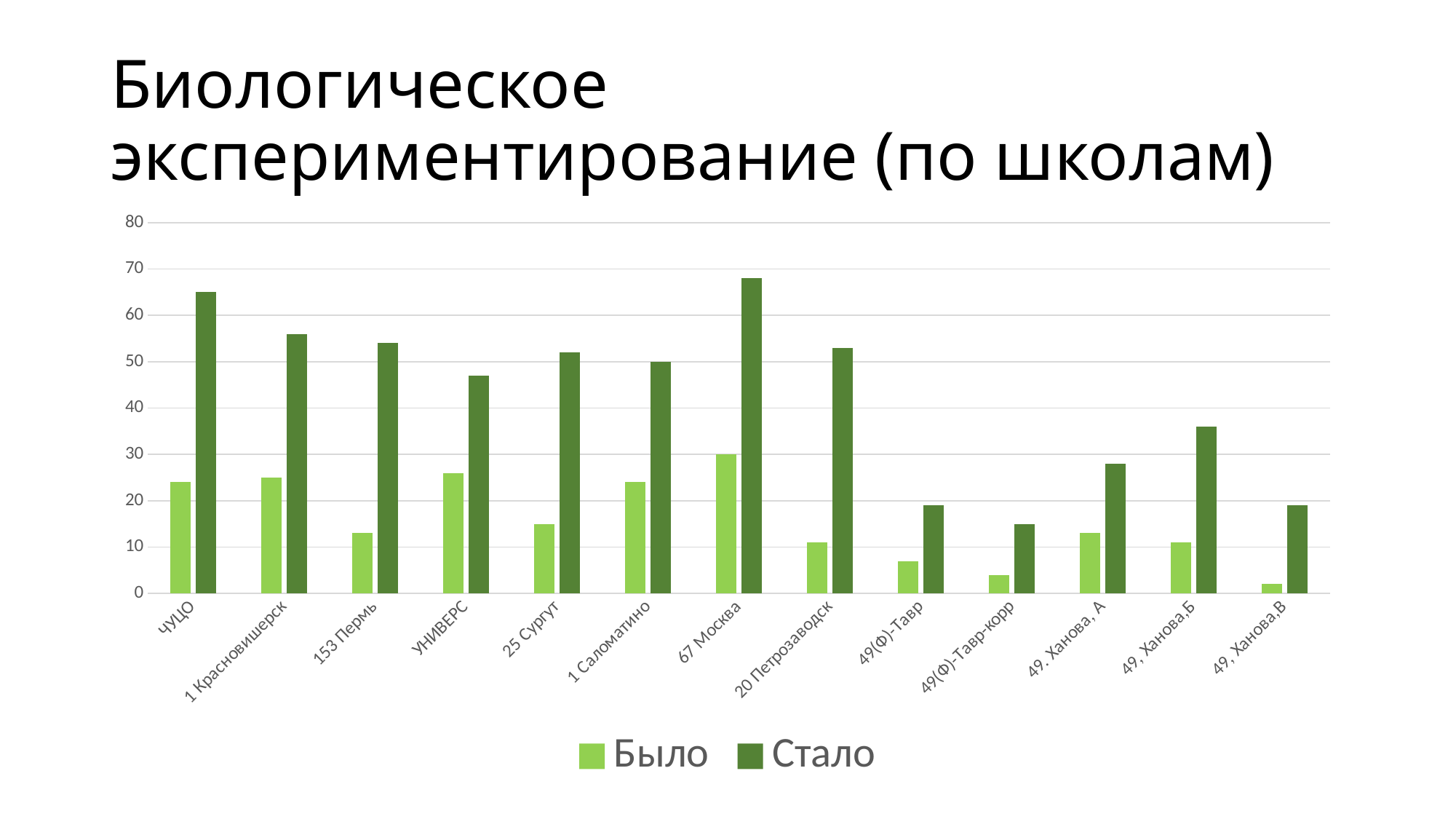
What is the title of the chart slide? Биологическое экспериментирование (по школам) Which is larger: the Было value for ЧУЦО or the Было value for 153 Пермь? ЧУЦО Which school has the highest value for the series Было? 67 Москва How many series does the legend list? 2 Which school has the lowest value for the series Было? 49, Ханова,В What kind of chart is shown on the slide? bar chart Is the Стало value for 49, Ханова,Б greater or less than 30? greater Is the Было value for 25 Сургут greater or less than 20? less Is the Было value for 49(Ф)-Тавр-корр greater or less than 10? less Which school has the lowest value for the series Стало? 49(Ф)-Тавр-корр How many schools (categories) are shown on the x axis? 13